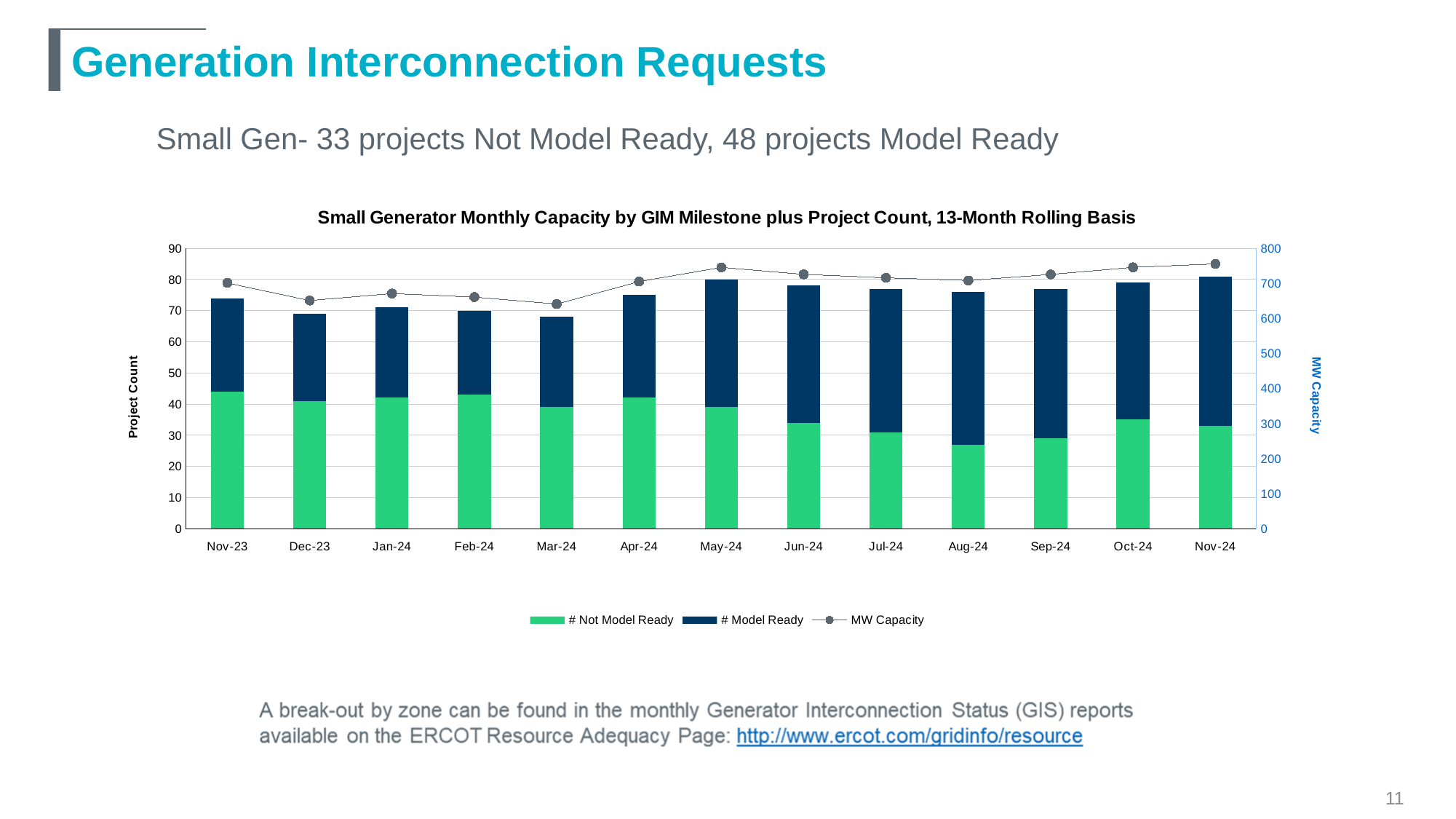
Is the MW Capacity value for May-24 greater or less than 700? greater Which is larger, the # Not Model Ready value for Nov-23 or for Aug-24? Nov-23 What type of chart is shown on the slide? Stacked bar chart with a line Is the MW Capacity value for Mar-24 greater or less than 700? less How many series does the chart legend list? 3 Does the # Not Model Ready value generally rise or fall from Nov-23 to Aug-24? fall Is the # Not Model Ready value for Nov-23 greater or less than 40? greater What is the title of the chart? Small Generator Monthly Capacity by GIM Milestone plus Project Count, 13-Month Rolling Basis Which month has the lowest # Not Model Ready value? Aug-24 How many months are shown on the x axis of the chart? 13 What is the label of the right-hand vertical axis? MW Capacity